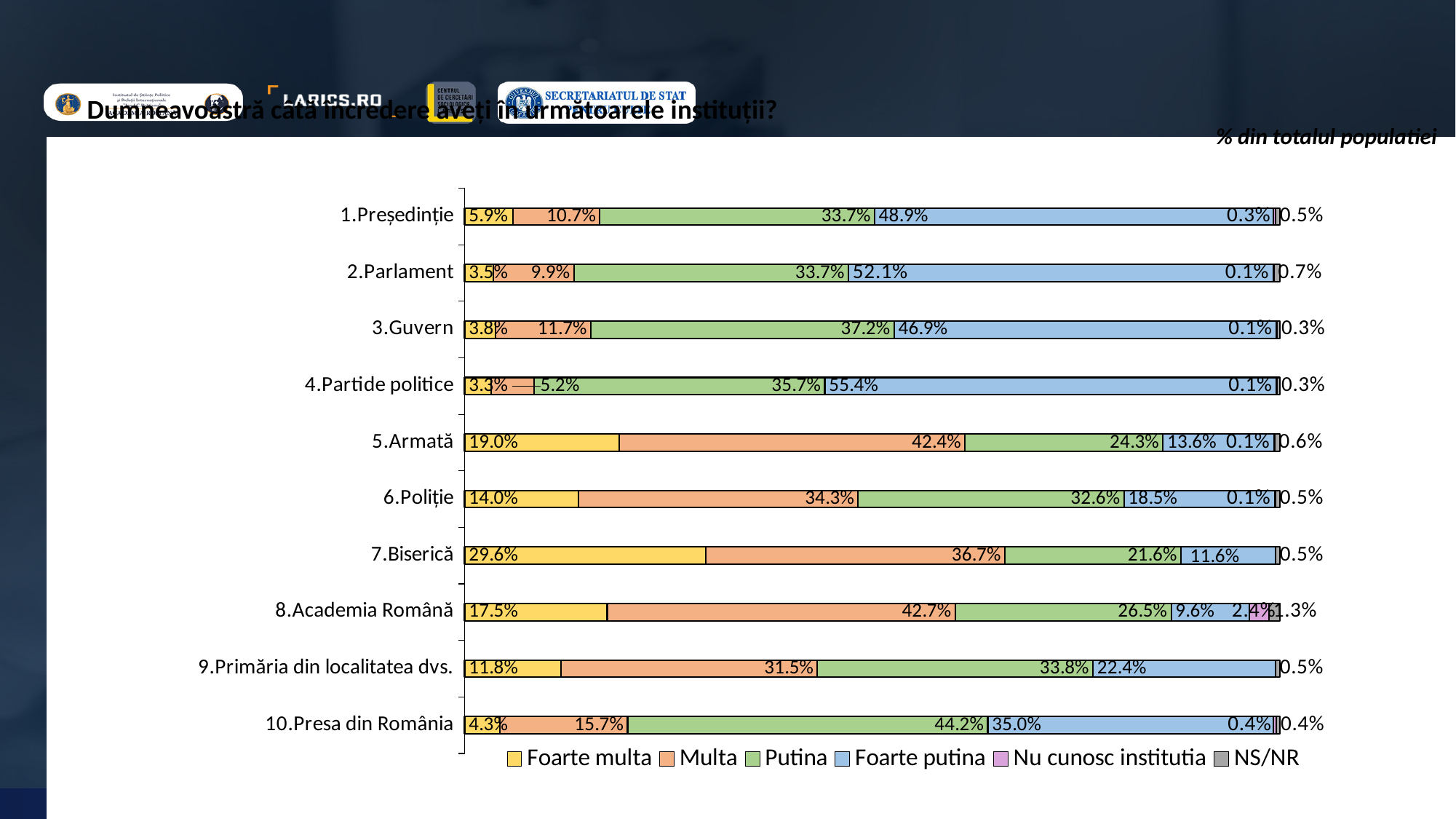
What is the 'Foarte putina' value for 2.Parlament? 52.1% What kind of chart is shown on the slide? Stacked bar chart What is the difference between the 'Multa' value for 5.Armată and the 'Multa' value for 6.Poliție? 8.1% Which institution has the highest 'Foarte multa' value? 7.Biserică Which institution has the highest 'Foarte putina' value? 4.Partide politice Which has the larger 'Putina' value, 3.Guvern or 10.Presa din România? 10.Presa din România Which legend entry is shown in green? Putina What is the 'Foarte multa' value for 7.Biserică? 29.6% What is the 'Multa' value for 8.Academia Română? 42.7% How many series does the legend list? 6 How many institutions (categories) are listed on the chart? 10 Which institution has the lowest 'Multa' value? 4.Partide politice